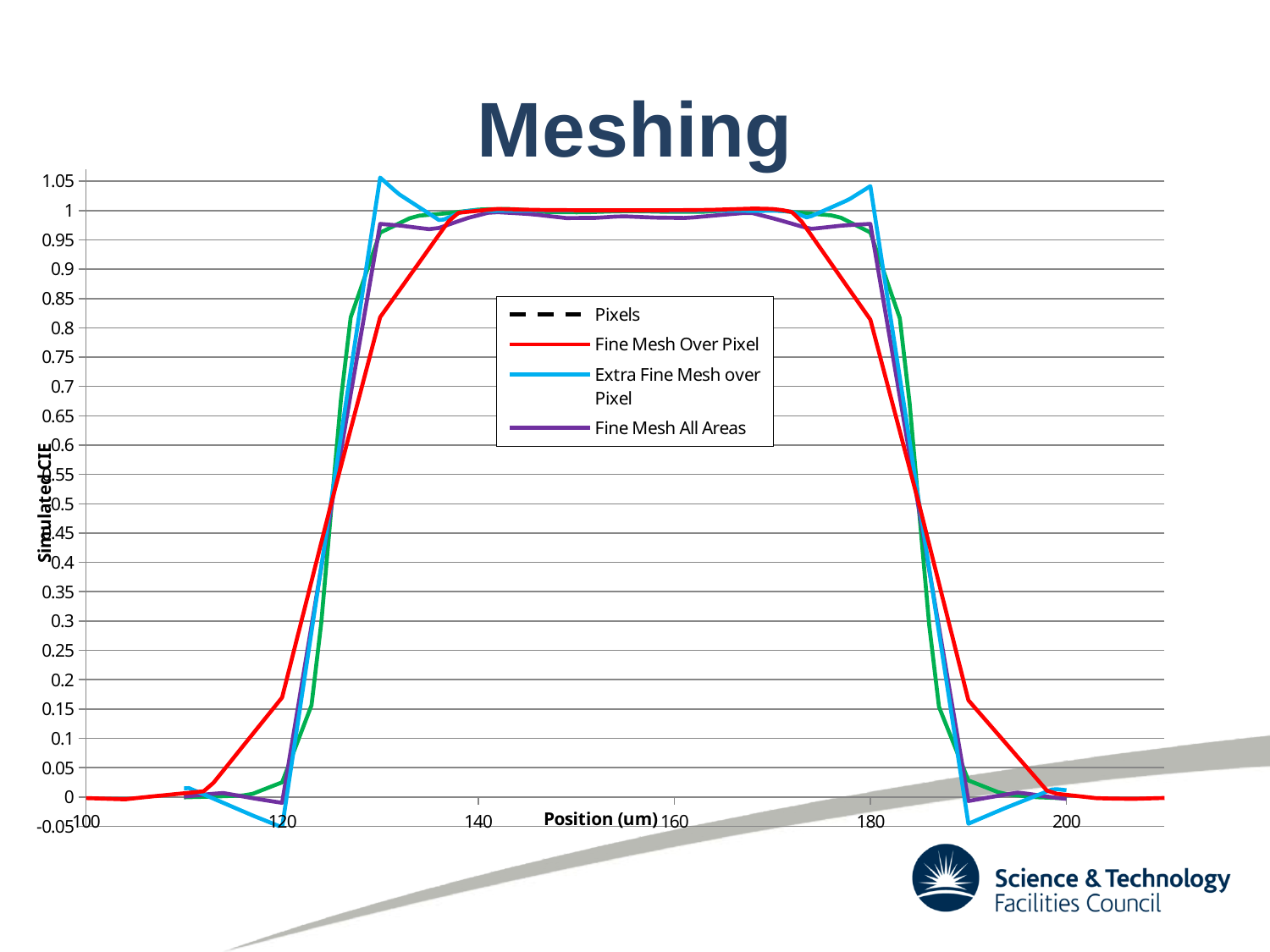
What type of chart is shown on the slide? Line chart Does the Fine Mesh Over Pixel series rise or fall between positions 180 and 190? Fall Is the value of Fine Mesh All Areas at position 130 greater or less than 0.9? greater Is the value of Fine Mesh Over Pixel at position 190 greater or less than 0.2? less Is the value of Fine Mesh Over Pixel at position 120 greater or less than 0.1? greater Does the Fine Mesh Over Pixel series rise or fall between positions 120 and 130? Rise What is the x-axis title of the chart? Position (um) At position 130, which series has the higher value: Extra Fine Mesh over Pixel or Fine Mesh Over Pixel? Extra Fine Mesh over Pixel How many series does the chart legend list? 4 What is the title of the chart on the slide? Meshing